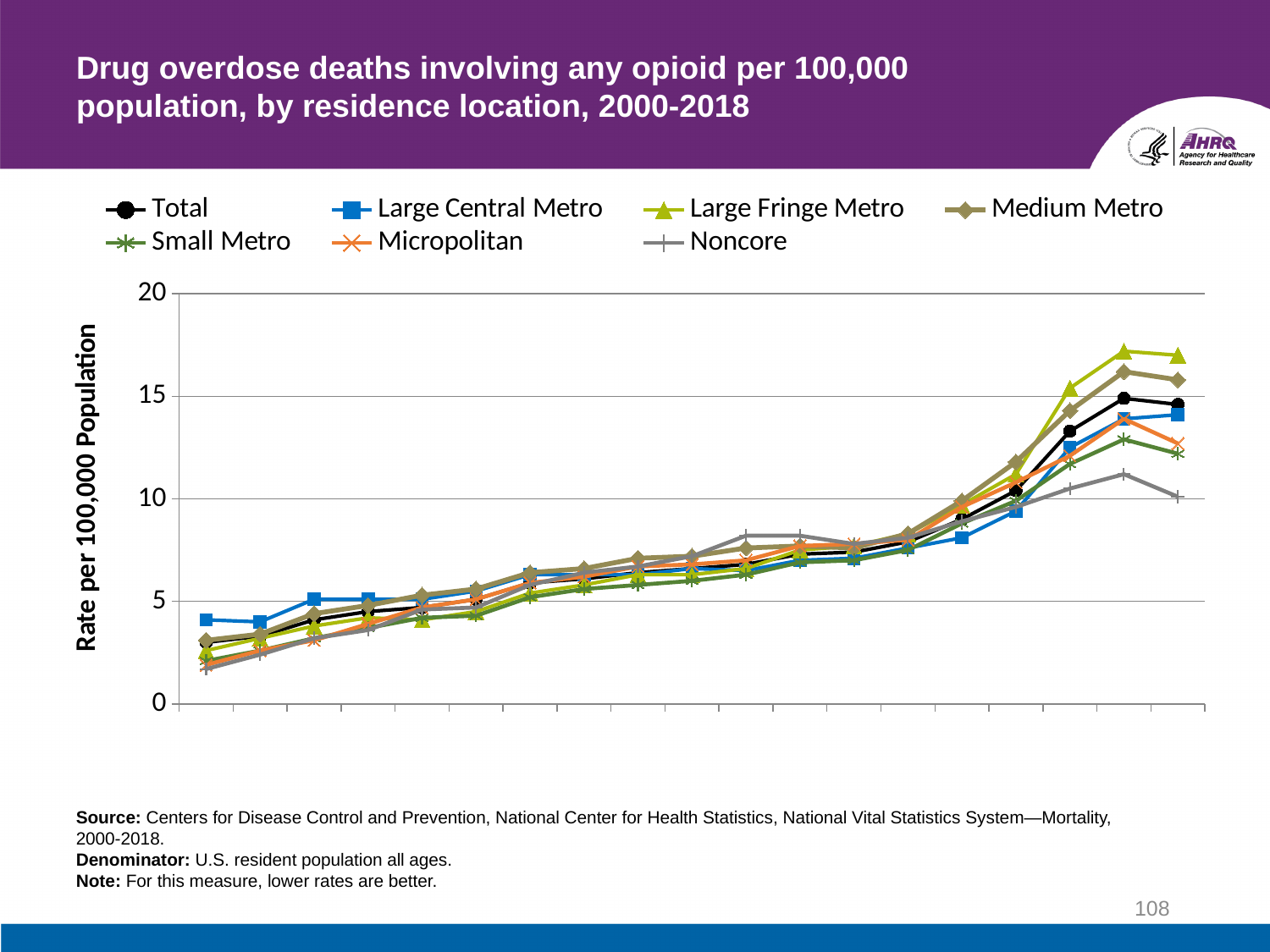
What is the label on the vertical axis? Rate per 100,000 Population What range of years does the chart cover? 2000-2018 At the end of the period, is the value for Large Fringe Metro or Noncore larger? Large Fringe Metro Which series has the lowest value at the end of the period (2018)? Noncore Which series has the highest value at the end of the period (2018)? Large Fringe Metro Is the value for Large Fringe Metro at the end of the period greater or less than 15? greater Is the highest value reached by Noncore greater or less than 10? greater What kind of chart is shown on the slide? line chart How many series does the legend list? 7 Is the value for Large Central Metro at the start of the period greater or less than 5? less Do the values for Total generally rise or fall from 2000 to 2018? rise